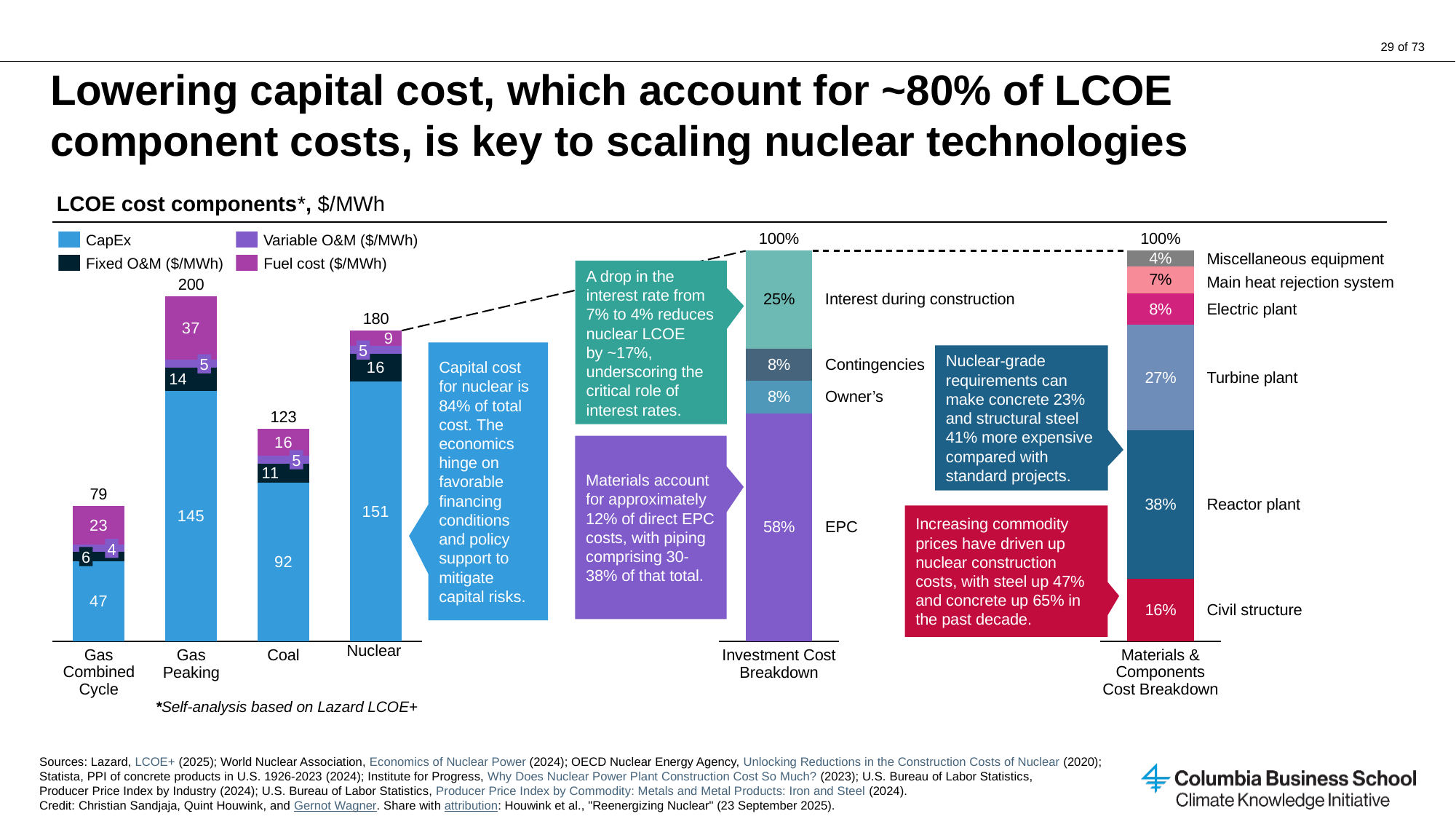
How many series does the legend of the LCOE cost components chart list? 4 What kind of chart is the LCOE cost components chart? Stacked bar chart In the LCOE cost components chart, what is the Fuel cost value for Gas Peaking? 37 In the Materials & Components Cost Breakdown chart, what share is Reactor plant? 38% In the LCOE cost components chart, what is the difference between the CapEx value for Nuclear and the CapEx value for Coal? 59 In the LCOE cost components chart, which category has the highest total? Gas Peaking In the LCOE cost components chart, which category has the lowest total? Gas Combined Cycle In the Investment Cost Breakdown chart, what share is EPC? 58% In the LCOE cost components chart, what is the total value shown above the Nuclear bar? 180 In the LCOE cost components chart, what is the CapEx value for Gas Peaking? 145 In the LCOE cost components chart, how many categories are shown on the x axis? 4 In the Materials & Components Cost Breakdown chart, which segment is the smallest? Miscellaneous equipment